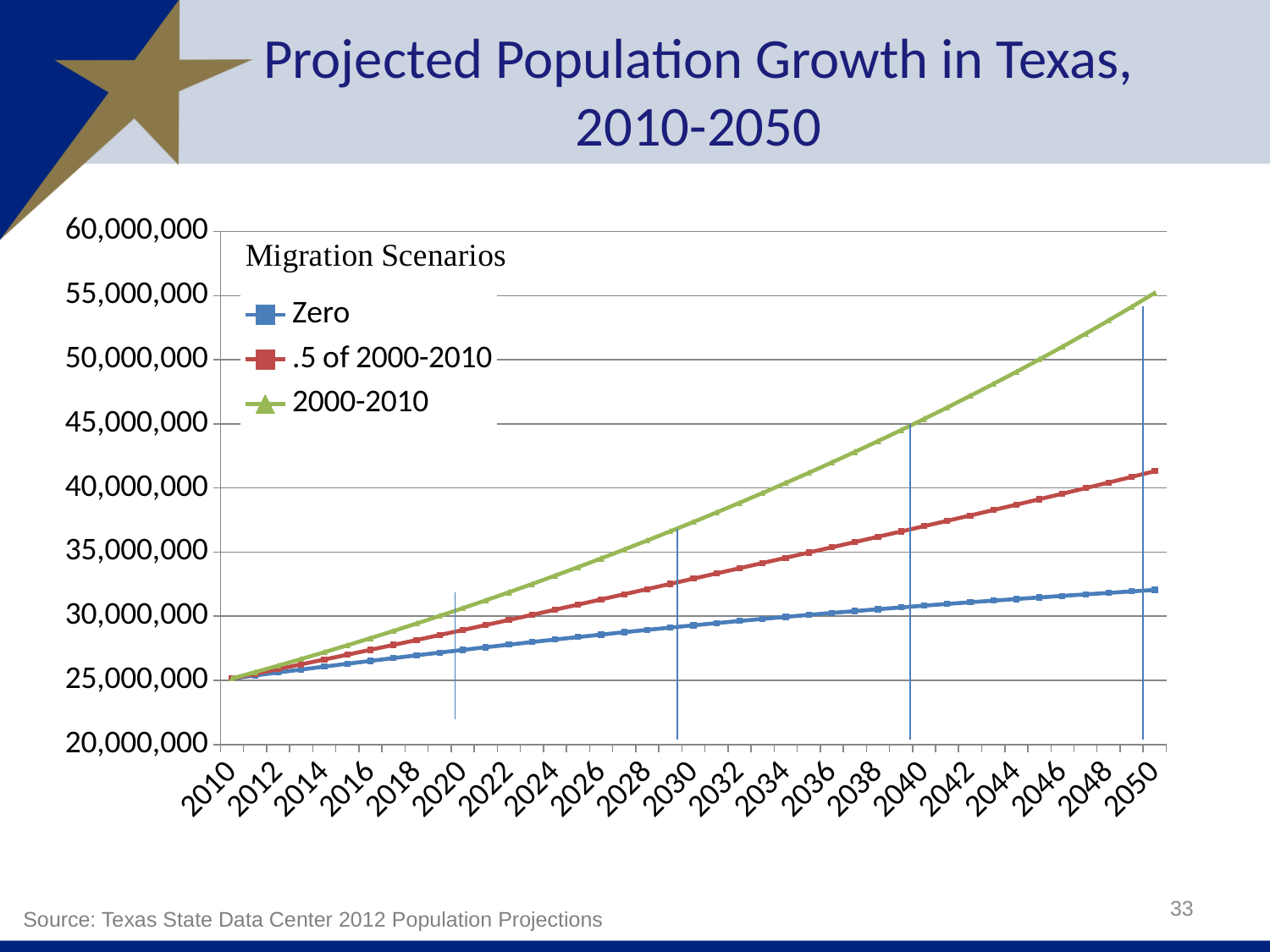
How many year labels are shown on the x axis? 21 In 2040, which is larger: the value for the 2000-2010 scenario or the value for the Zero scenario? 2000-2010 What is the title of the chart? Projected Population Growth in Texas, 2010-2050 Which migration scenario has the highest projected population in 2050? 2000-2010 How many series does the legend list? 3 What heading is given to the legend? Migration Scenarios Which migration scenario has the lowest projected population in 2050? Zero Is the value for the .5 of 2000-2010 scenario in 2040 greater or less than 35,000,000? greater What kind of chart is shown on the slide? line chart Is the value for the 2000-2010 scenario in 2050 greater or less than 50,000,000? greater Is the value for the Zero scenario in 2030 greater or less than 30,000,000? less Do the values for the 2000-2010 scenario rise or fall from 2010 to 2050? rise